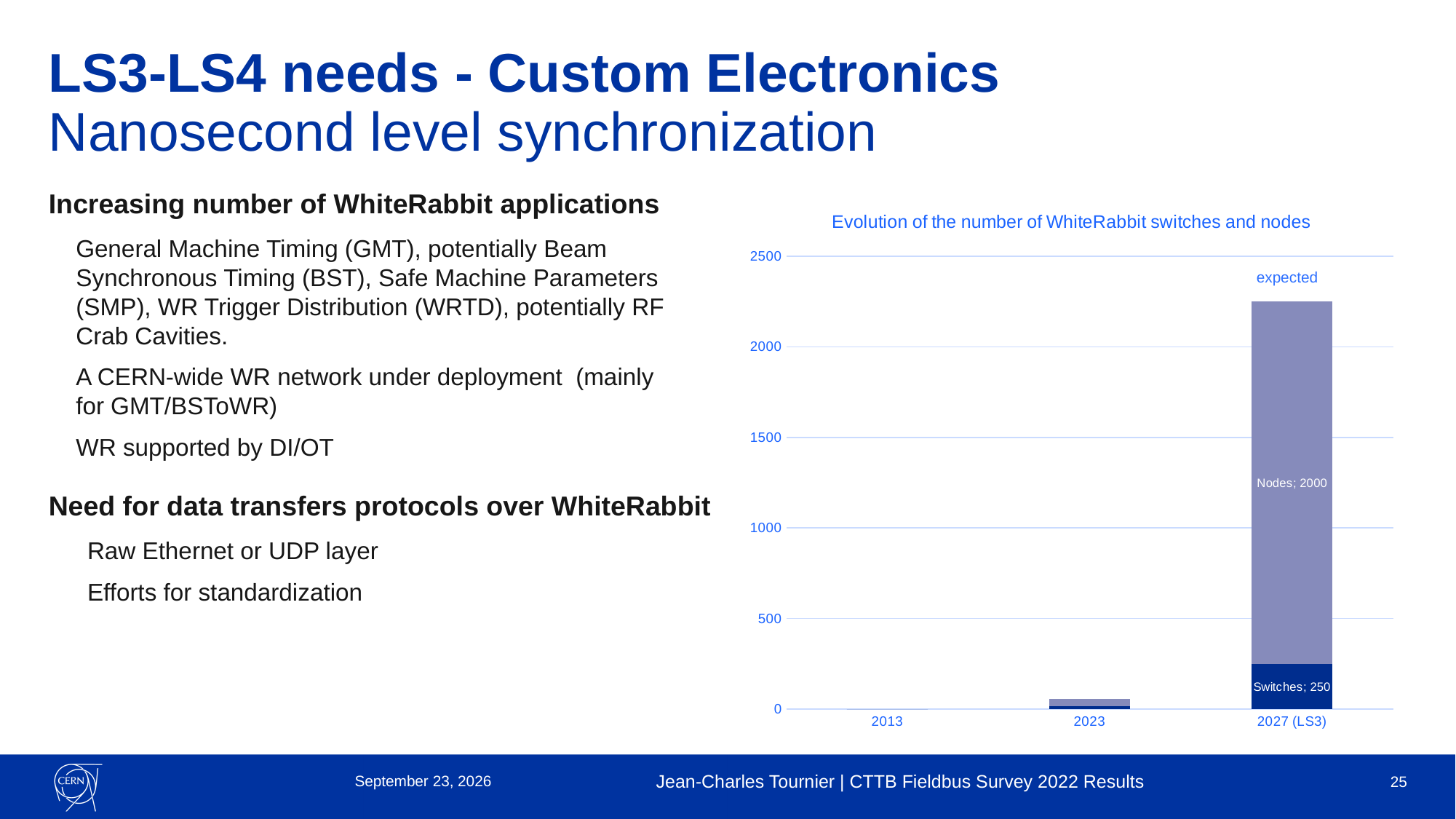
What kind of chart is shown? stacked bar chart What is the difference between the Nodes and Switches values for 2027 (LS3)? 1750 Do the bar heights rise or fall from 2013 to 2027 (LS3)? rise Which year has the tallest bar? 2027 (LS3) What is the value for Nodes in 2027 (LS3)? 2000 What is the value for Switches in 2027 (LS3)? 250 In 2027 (LS3), which is larger, Nodes or Switches? Nodes How many years are shown on the x axis? 3 What is the total height of the stacked bar for 2027 (LS3)? 2250 Is the total value for 2023 greater or less than 500? less Which year has the smallest bar? 2013 What is the title of the chart? Evolution of the number of WhiteRabbit switches and nodes